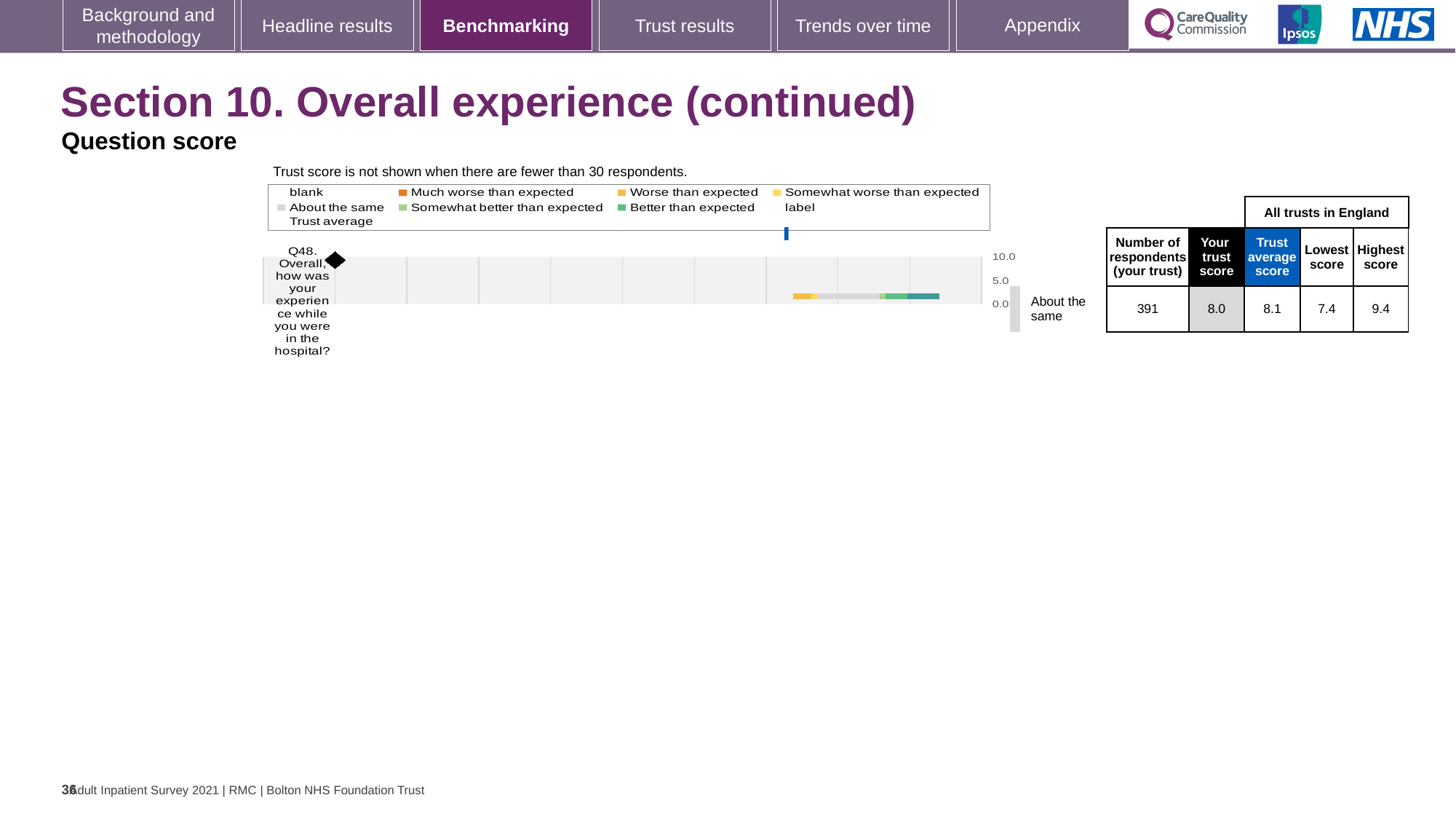
What is the maximum value shown on the chart's score axis? 10.0 What is the highest score for Q48 among all trusts in England? 9.4 How many questions are plotted on the benchmarking chart? 1 What is the trust average score for Q48 across all trusts in England? 8.1 Which is larger for Q48: the trust score or the trust average score? Trust average score How many respondents answered Q48 for this trust? 391 What is the difference between the highest score and the lowest score for Q48 among all trusts in England? 2.0 What is the lowest score for Q48 among all trusts in England? 7.4 Which question is shown on the benchmarking chart? Q48. Overall, how was your experience while you were in the hospital? What kind of chart is used to show the benchmarking result for Q48? bar chart Which benchmarking category is the trust's Q48 score placed in? About the same What is the trust score for Q48 shown next to the chart? 8.0